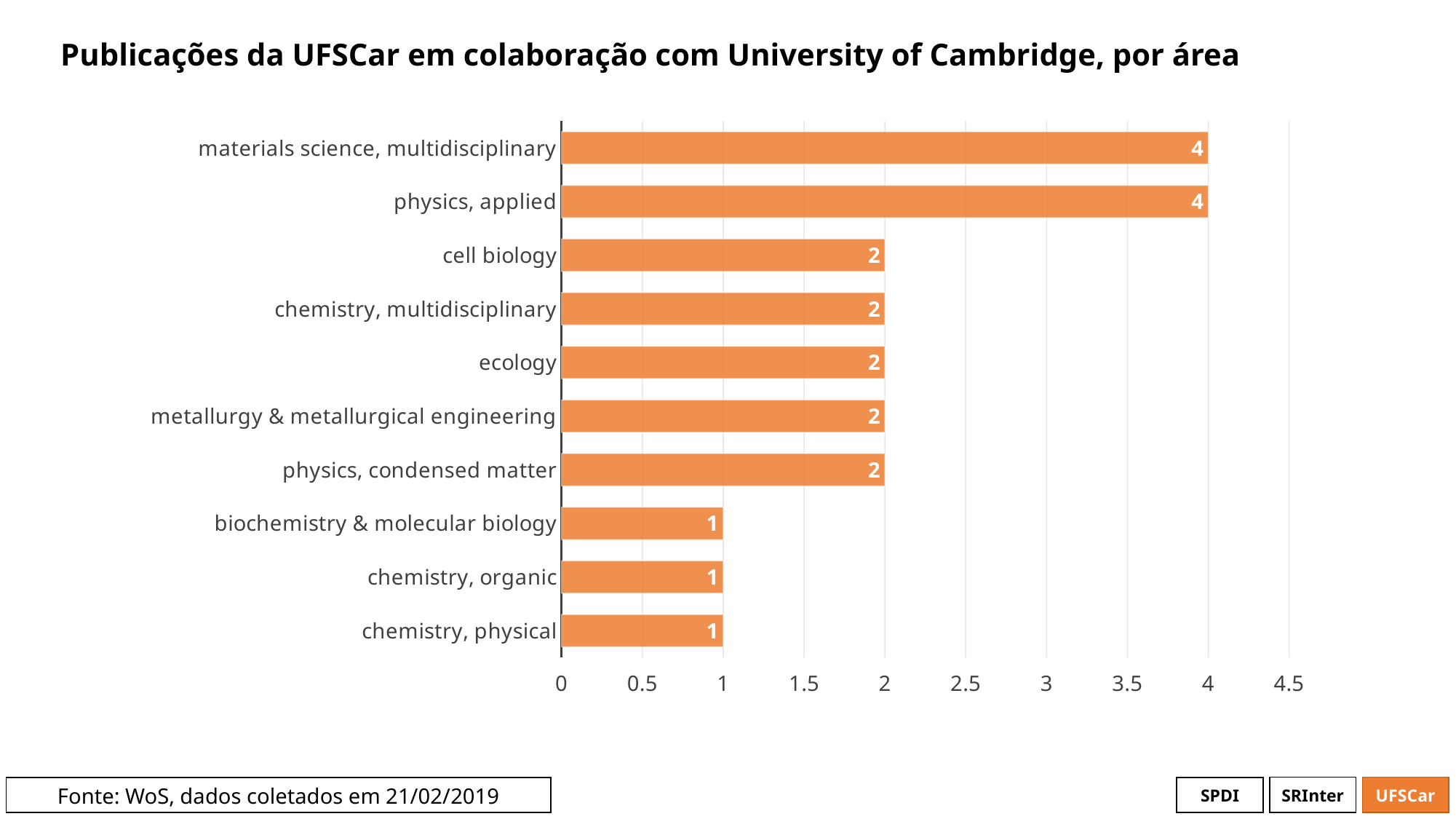
How many categories are shown in the chart? 10 What kind of chart is shown on the slide? bar chart Is the value for materials science, multidisciplinary greater or less than 3? greater Which is larger, the value for physics, applied or the value for biochemistry & molecular biology? physics, applied What is the value for physics, applied? 4 What is the title of the chart? Publicações da UFSCar em colaboração com University of Cambridge, por área What is the difference between the values for materials science, multidisciplinary and ecology? 2 What is the value for metallurgy & metallurgical engineering? 2 What is the value for cell biology? 2 What is the difference between the values for physics, condensed matter and chemistry, physical? 1 Which is larger, the value for chemistry, multidisciplinary or the value for chemistry, organic? chemistry, multidisciplinary What is the value for chemistry, organic? 1